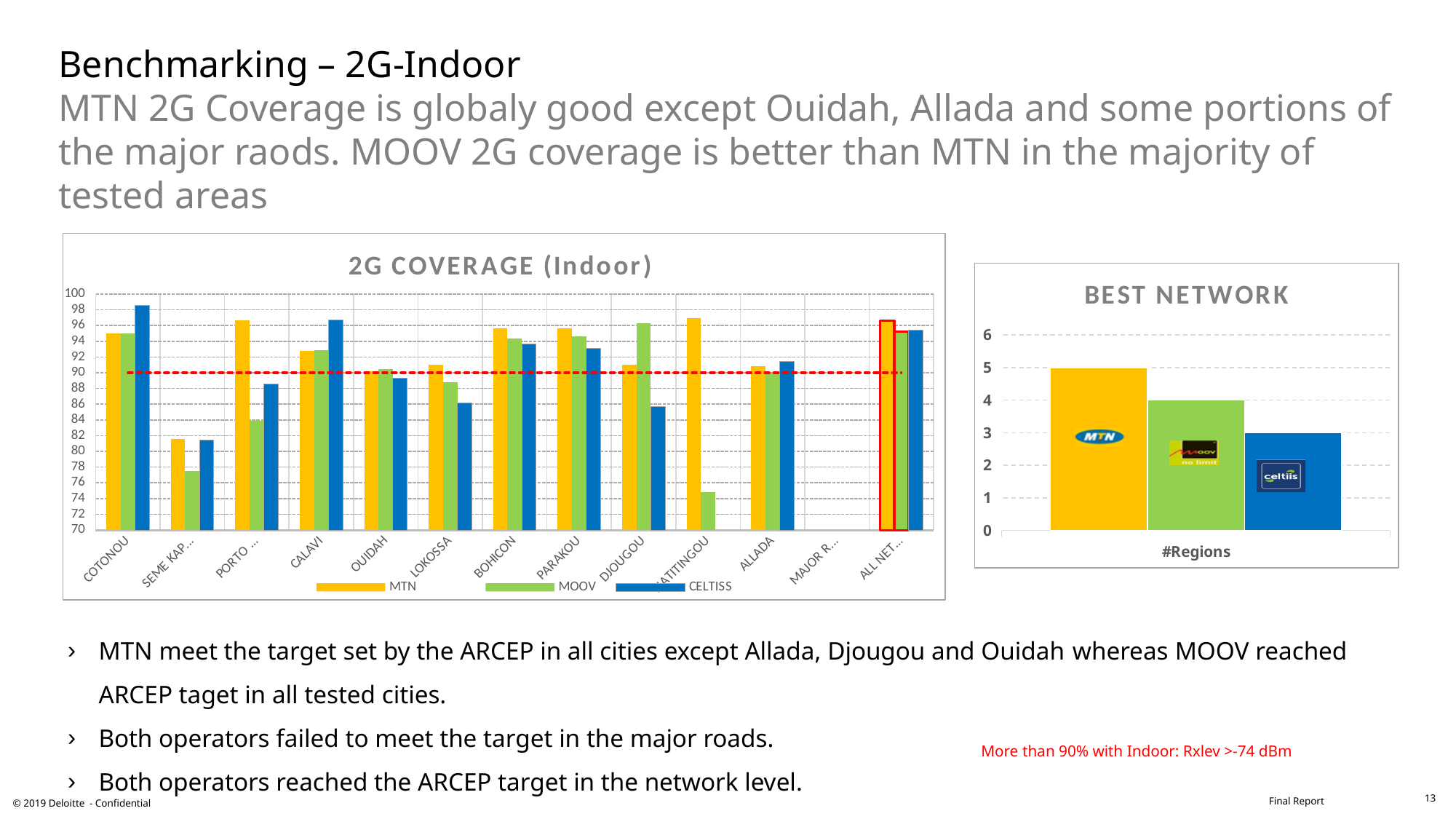
In the 2G COVERAGE (Indoor) chart, which series has the highest value for COTONOU? CELTISS In the BEST NETWORK chart, what is the value for MOOV? 4 In the BEST NETWORK chart, what is the difference between the MTN and MOOV values? 1 In the BEST NETWORK chart, what is the value for CELTIIS? 3 In the 2G COVERAGE (Indoor) chart, which is larger for NATITINGOU, the MTN value or the MOOV value? MTN In the BEST NETWORK chart, what is the value for MTN? 5 In the 2G COVERAGE (Indoor) chart, how many categories are shown on the x axis? 13 What kind of chart is the 2G COVERAGE (Indoor) chart? bar chart In the 2G COVERAGE (Indoor) chart, is the MOOV value for NATITINGOU greater or less than 78? less In the BEST NETWORK chart, which network has the highest number of regions? MTN In the 2G COVERAGE (Indoor) chart, how many series does the legend list? 3 In the 2G COVERAGE (Indoor) chart, is the CELTISS value for COTONOU greater or less than 96? greater